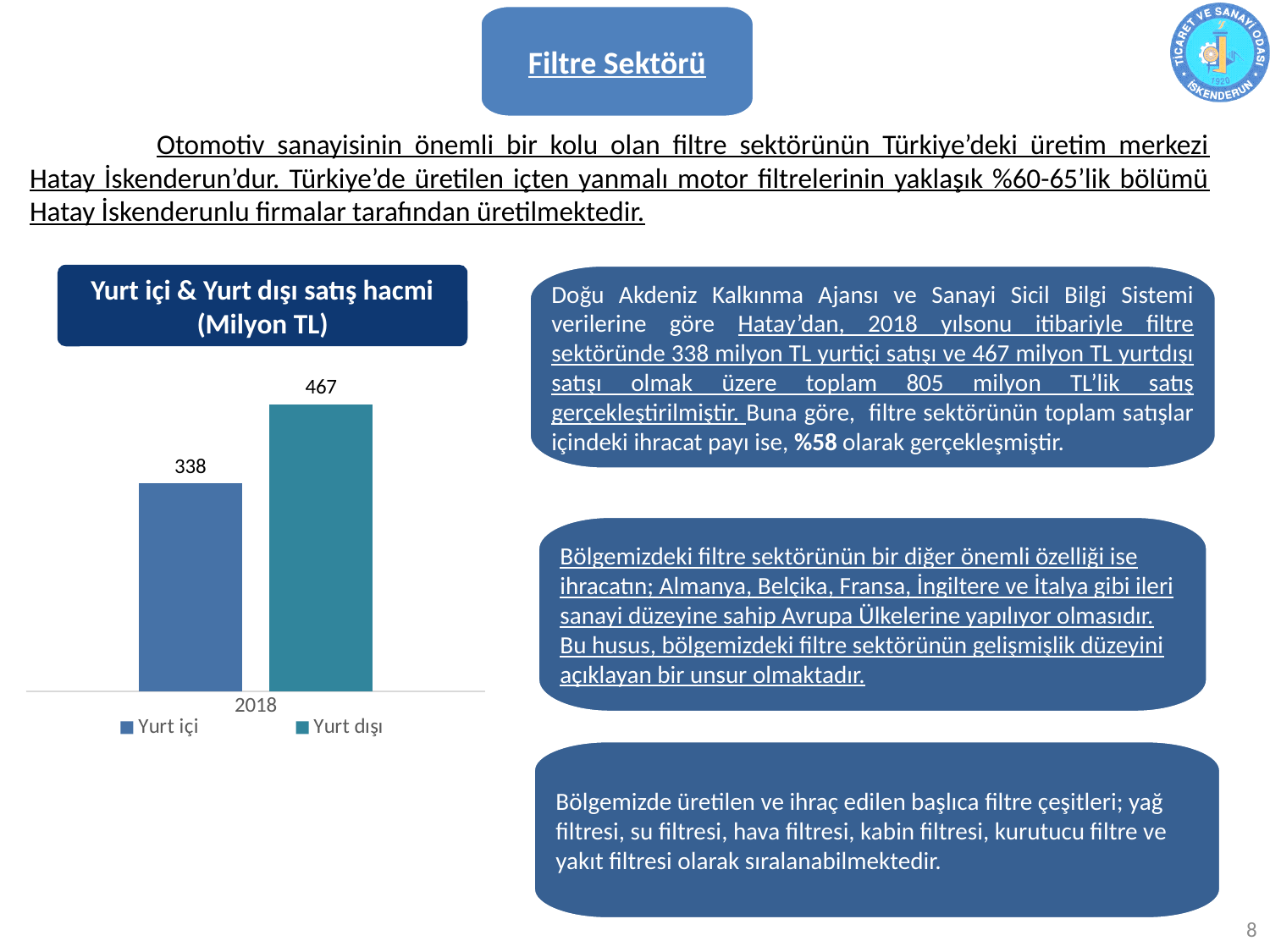
Which year is shown on the x axis of the chart? 2018 What is the combined total of Yurt içi and Yurt dışı sales in 2018? 805 Which series has the higher value in 2018, Yurt içi or Yurt dışı? Yurt dışı What is the title of the chart? Yurt içi & Yurt dışı satış hacmi (Milyon TL) What kind of chart is shown on the slide? Bar chart How many categories are shown on the x axis of the chart? 1 What is the value for Yurt dışı in 2018? 467 How many series does the legend list? 2 What is the difference between the Yurt dışı and Yurt içi values in 2018? 129 Which series has the lowest value in the chart? Yurt içi What is the value for Yurt içi in 2018? 338